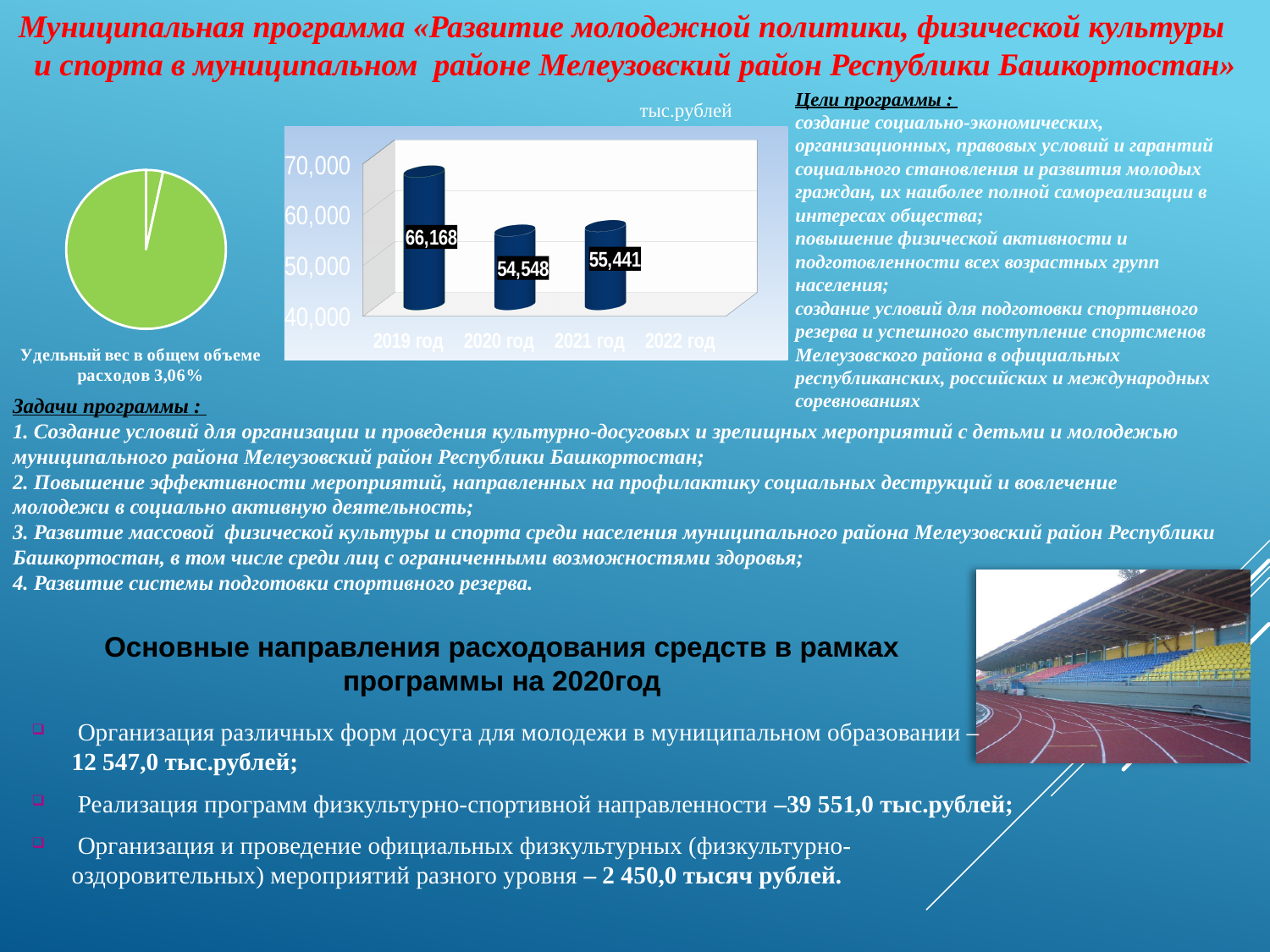
On the bar chart, which is larger: the value for 2019 год or the value for 2021 год? 2019 год On the bar chart, which year has the lowest plotted value? 2020 год On the bar chart, what is the value for 2021 год? 55,441 On the bar chart, how many bars are plotted? 3 On the bar chart, what is the difference between the values for 2019 год and 2020 год? 11,620 On the bar chart, do the values rise or fall from 2019 год to 2020 год? fall On the bar chart, what is the value for 2019 год? 66,168 On the bar chart, which year has the highest value? 2019 год On the bar chart, what is the difference between the values for 2021 год and 2020 год? 893 On the bar chart, what is the value for 2020 год? 54,548 What kind of chart shows the values by year on the slide? bar chart On the bar chart, is the value for 2019 год greater or less than 60,000? greater